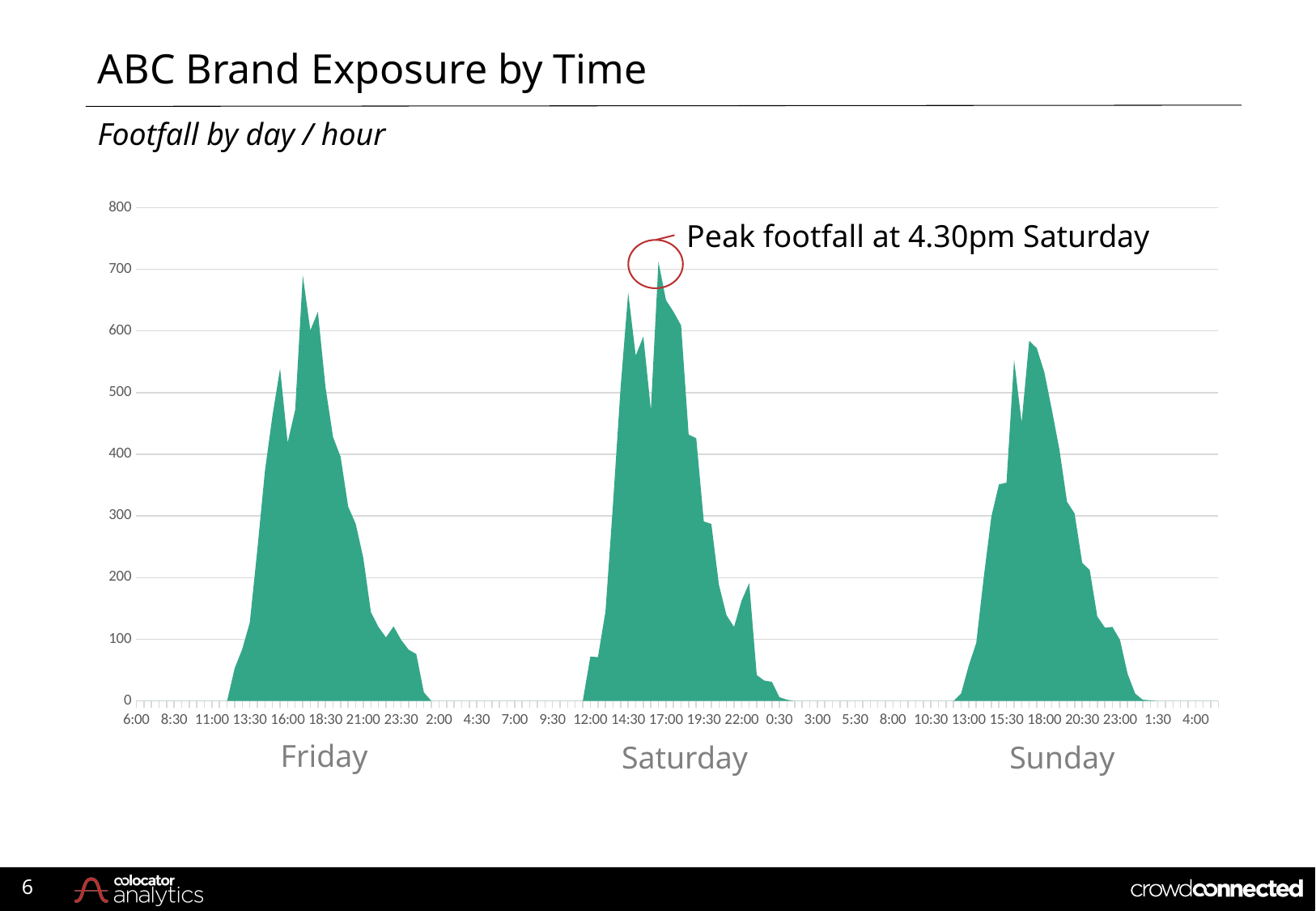
What kind of chart is shown on the slide? Area chart Which day has a higher peak footfall, Friday or Sunday? Friday How many days are shown along the x axis of the chart? 3 Is the peak footfall on Friday greater or less than 600? greater At what time does the annotation say peak footfall occurred? 4.30pm Saturday Is the peak footfall on Saturday greater or less than 600? greater On which day does footfall reach its highest peak? Saturday What is the highest value shown on the y axis of the chart? 800 What is the title of the slide containing the chart? ABC Brand Exposure by Time Is the peak footfall on Sunday greater or less than 500? greater On which day is the highest peak of footfall the lowest of the three days? Sunday